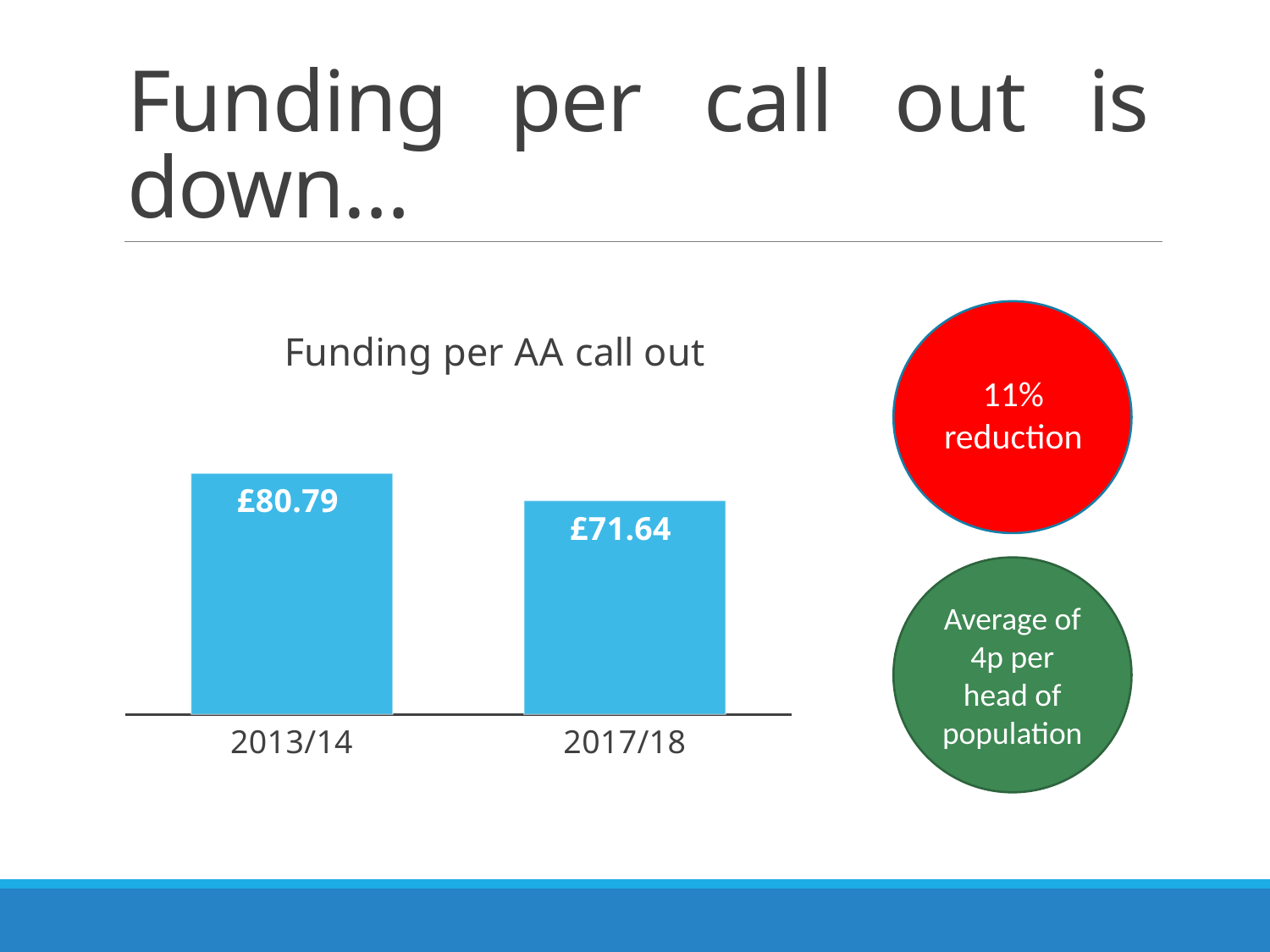
What is the difference in funding per AA call out between 2013/14 and 2017/18? £9.15 Which year has the higher funding per AA call out? 2013/14 What kind of chart is shown on the slide? Bar chart How many years are shown in the chart? 2 What is the title of the chart? Funding per AA call out What is the funding per AA call out for 2017/18? £71.64 Does the funding per AA call out rise or fall from 2013/14 to 2017/18? Fall Which year has the lower funding per AA call out? 2017/18 Is the funding per AA call out larger in 2013/14 or 2017/18? 2013/14 What colour are the bars in the chart? Blue What is the funding per AA call out for 2013/14? £80.79